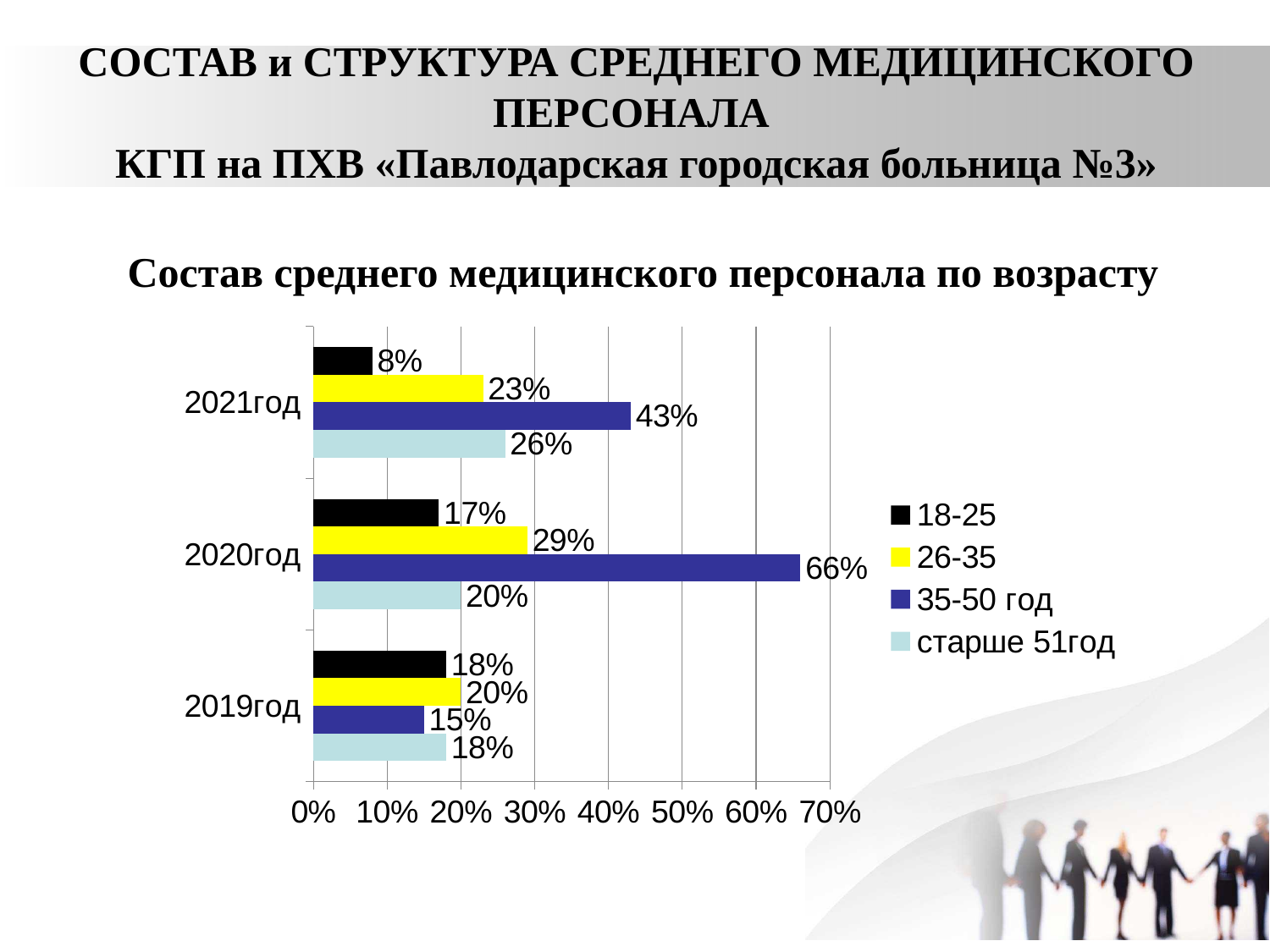
What is the value for the 35-50 год series in 2020год? 66% How many year categories are shown on the chart? 3 Which year has the lowest value for the 18-25 series? 2021год How many series does the legend list? 4 What is the title of the chart? Состав среднего медицинского персонала по возрасту What is the value for the 18-25 series in 2021год? 8% Which is larger in 2021год: the 26-35 value or the старше 51год value? старше 51год What colour represents the 26-35 series? yellow What kind of chart is shown on the slide? bar chart What is the value for the старше 51год series in 2019год? 18% Which year has the highest value for the 35-50 год series? 2020год What is the difference between the 35-50 год values for 2020год and 2021год? 23%